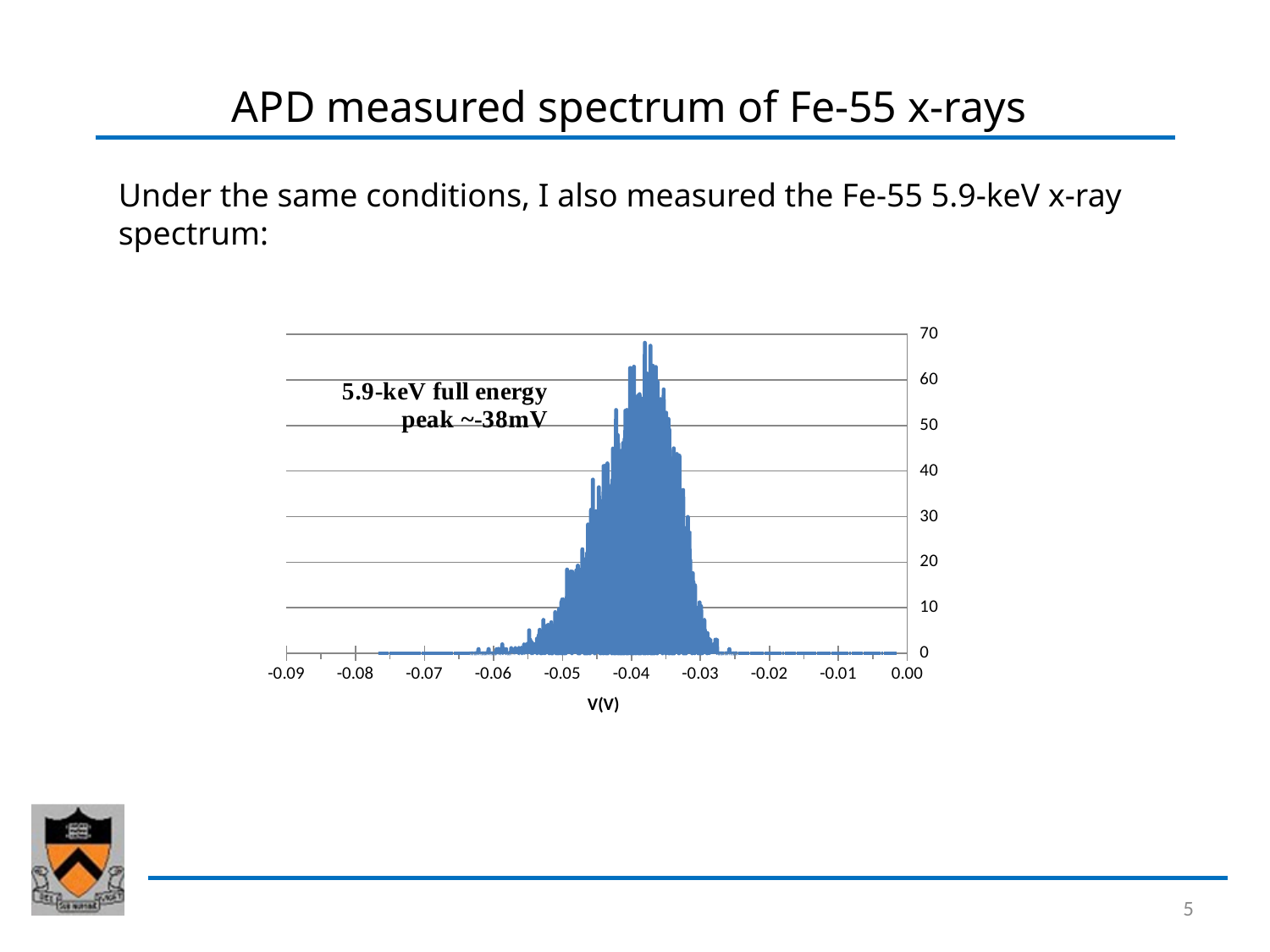
According to the annotation on the chart, where is the 5.9-keV full energy peak located? ~-38mV Which has the larger value in the spectrum, -0.05 V or -0.03 V? -0.05 V What kind of chart is shown on the slide? bar chart Is the tallest bar in the spectrum greater or less than 60? greater Moving along the x axis from -0.05 V to -0.04 V, do the values rise or fall? rise Is the value of the spectrum at -0.05 V greater or less than 30? less Is the value of the spectrum at -0.06 V greater or less than 10? less What is the label on the x axis of the chart? V(V) What is the highest value shown on the y axis of the chart? 70 Moving along the x axis from -0.04 V to -0.03 V, do the values rise or fall? fall Which has the larger value in the spectrum, -0.04 V or -0.06 V? -0.04 V